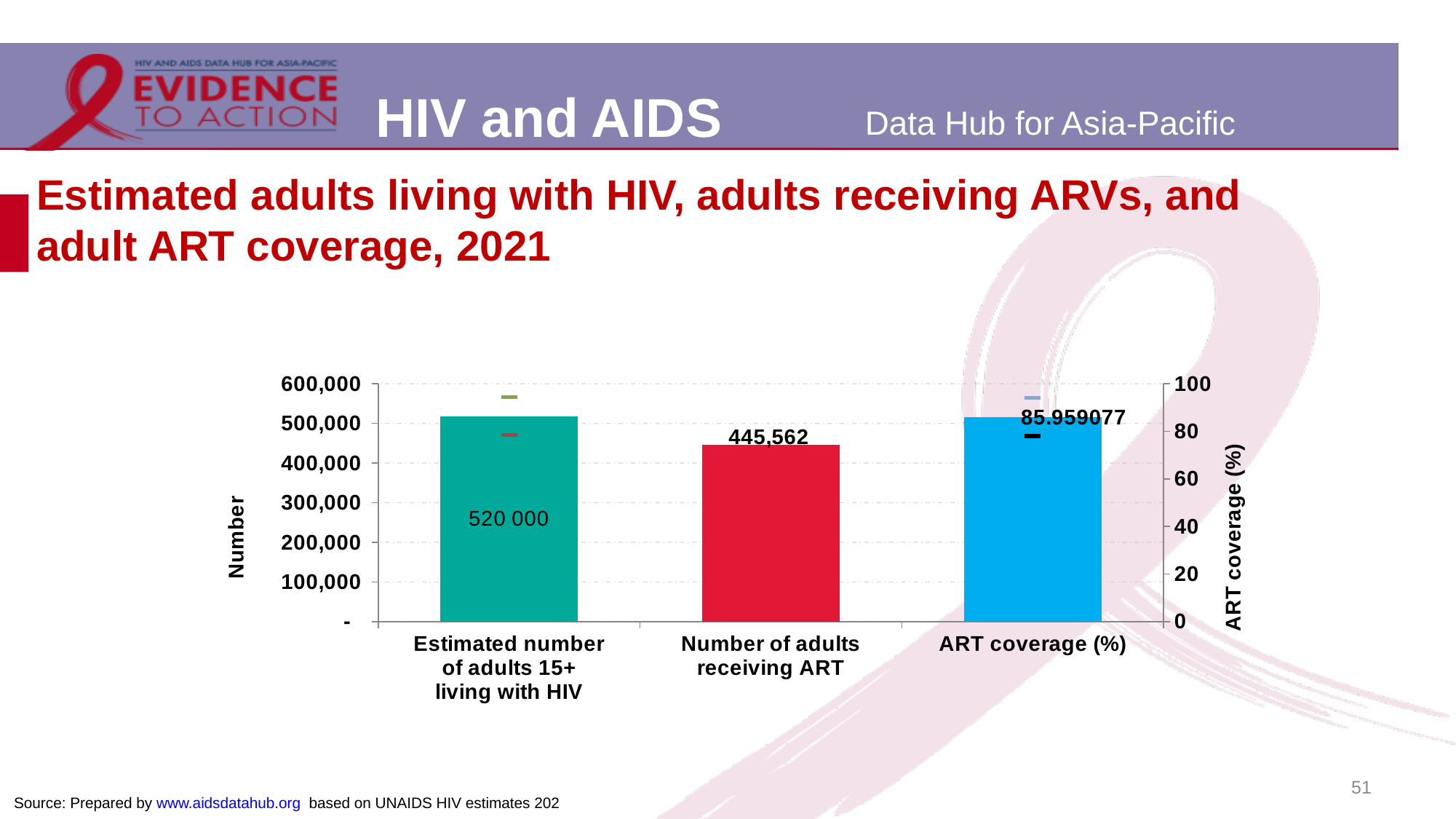
Is the value for the number of adults receiving ART greater or less than 500,000? less How many bars are plotted in the chart? 3 Which is larger: the estimated number of adults 15+ living with HIV or the number of adults receiving ART? Estimated number of adults 15+ living with HIV Is the value for the estimated number of adults 15+ living with HIV greater or less than 500,000? greater What is the value shown for ART coverage (%)? 85.959077 Is the value for ART coverage (%) greater or less than 80 on the right-hand axis? greater What is the title of the right-hand vertical axis? ART coverage (%) What kind of chart is shown on the slide? Bar chart What is the value shown for the estimated number of adults 15+ living with HIV? 520 000 What is the value shown for the number of adults receiving ART? 445,562 What is the title of the chart on the slide? Estimated adults living with HIV, adults receiving ARVs, and adult ART coverage, 2021 What is the difference between the estimated number of adults 15+ living with HIV and the number of adults receiving ART? 74,438